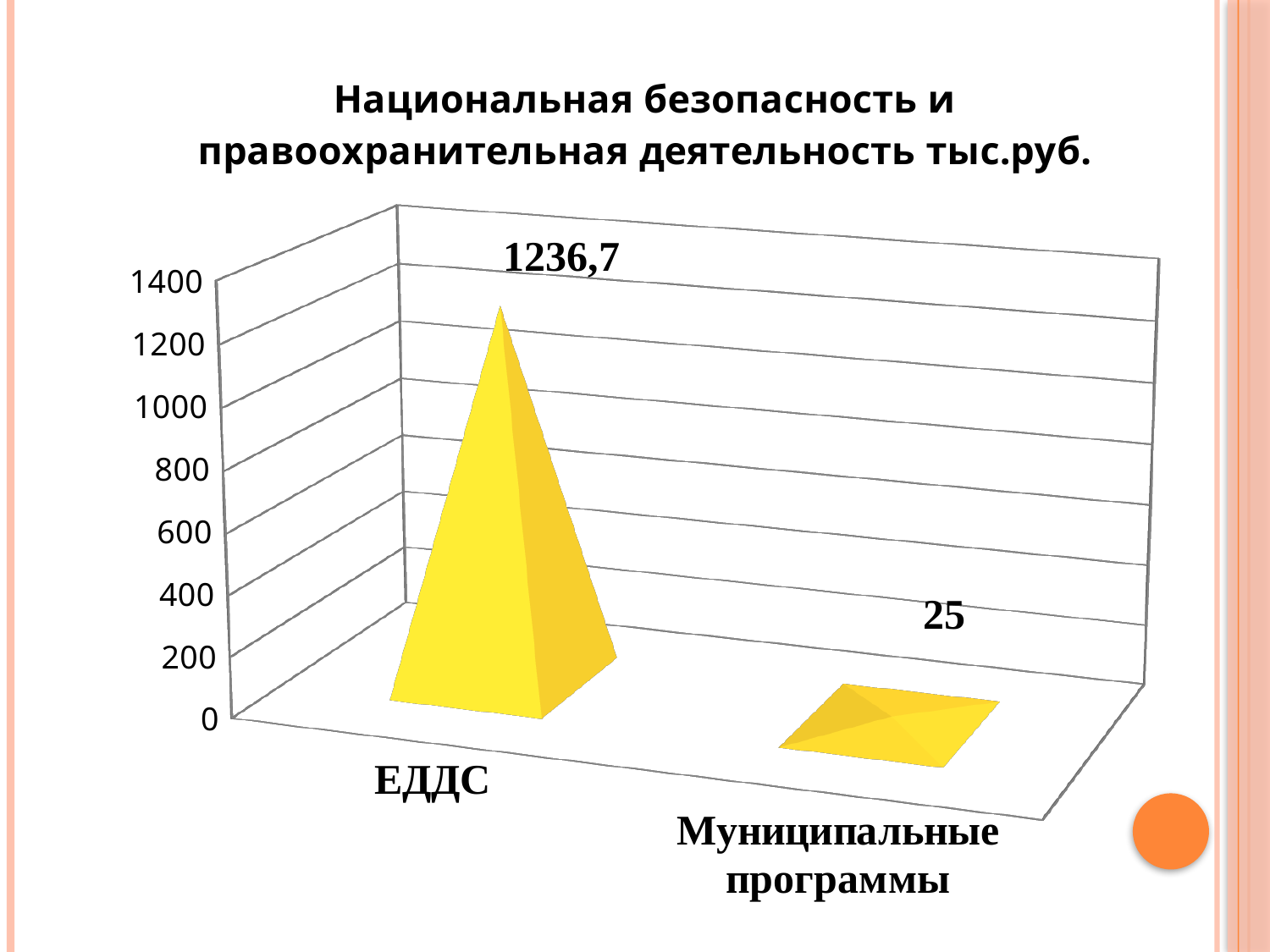
What is the title of the chart? Национальная безопасность и правоохранительная деятельность тыс.руб. What kind of chart is shown on the slide? bar chart What is the value for Муниципальные программы? 25 What is the difference between the values for ЕДДС and Муниципальные программы? 1211,7 What is the highest value shown on the vertical axis? 1400 Which category has the lowest value? Муниципальные программы How many categories are shown on the chart? 2 Which is larger, the value for ЕДДС or the value for Муниципальные программы? ЕДДС Is the value for ЕДДС greater or less than 1000? greater Which category has the highest value? ЕДДС What is the value for ЕДДС? 1236,7 Is the value for Муниципальные программы greater or less than 200? less